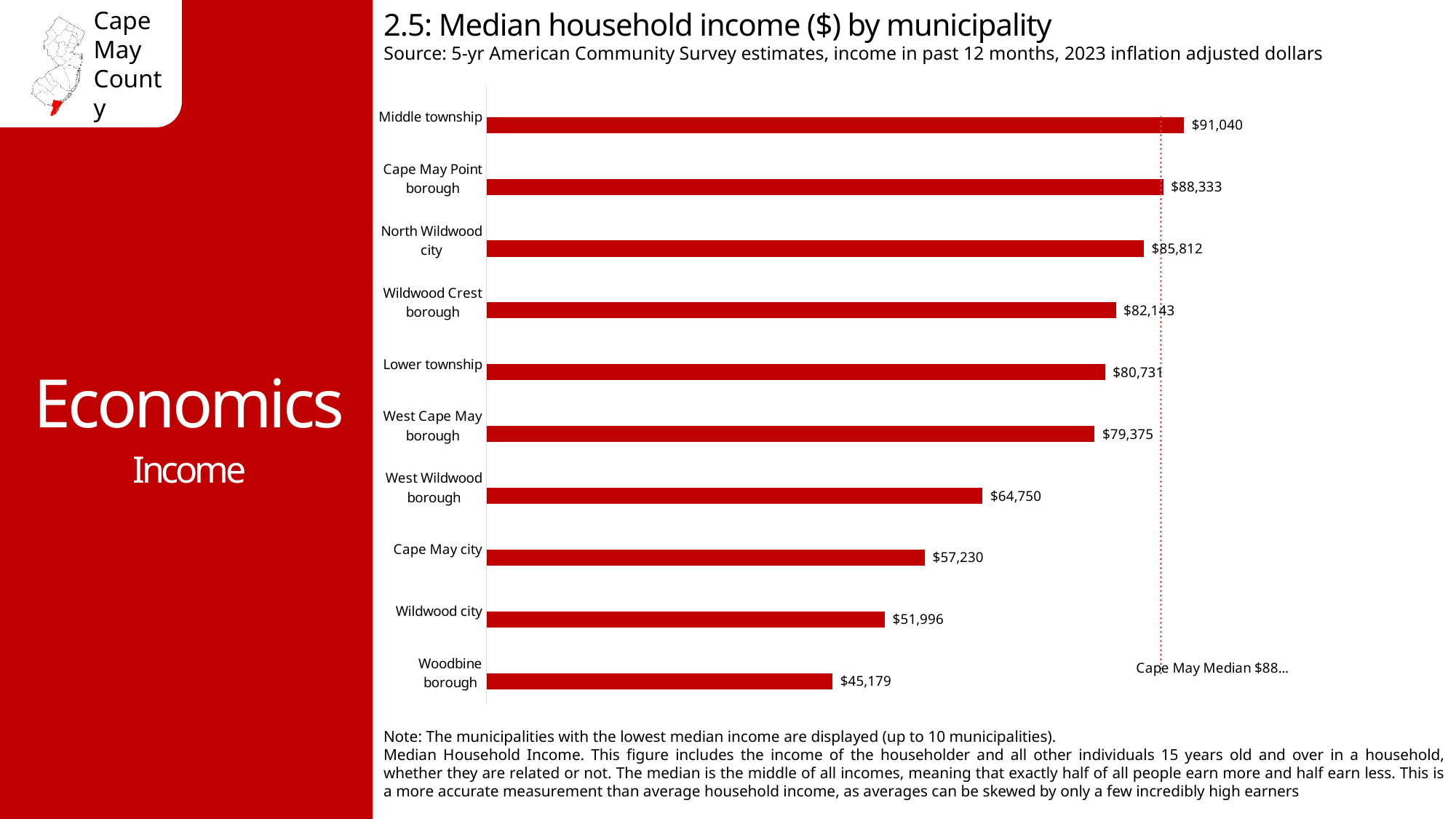
What is the median household income for Middle township? $91,040 What kind of chart is used to show median household income by municipality? Bar chart Which has a higher median household income, North Wildwood city or Wildwood Crest borough? North Wildwood city What is the median household income for West Wildwood borough? $64,750 What is the median household income for Lower township? $80,731 What is the difference in median household income between Middle township and Woodbine borough? $45,861 What is the title of the chart? 2.5: Median household income ($) by municipality Which municipality has the highest median household income on the chart? Middle township How many municipalities are shown on the chart? 10 Which municipality has the lowest median household income on the chart? Woodbine borough What is the difference in median household income between Cape May city and Wildwood city? $5,234 What is the median household income for Woodbine borough? $45,179